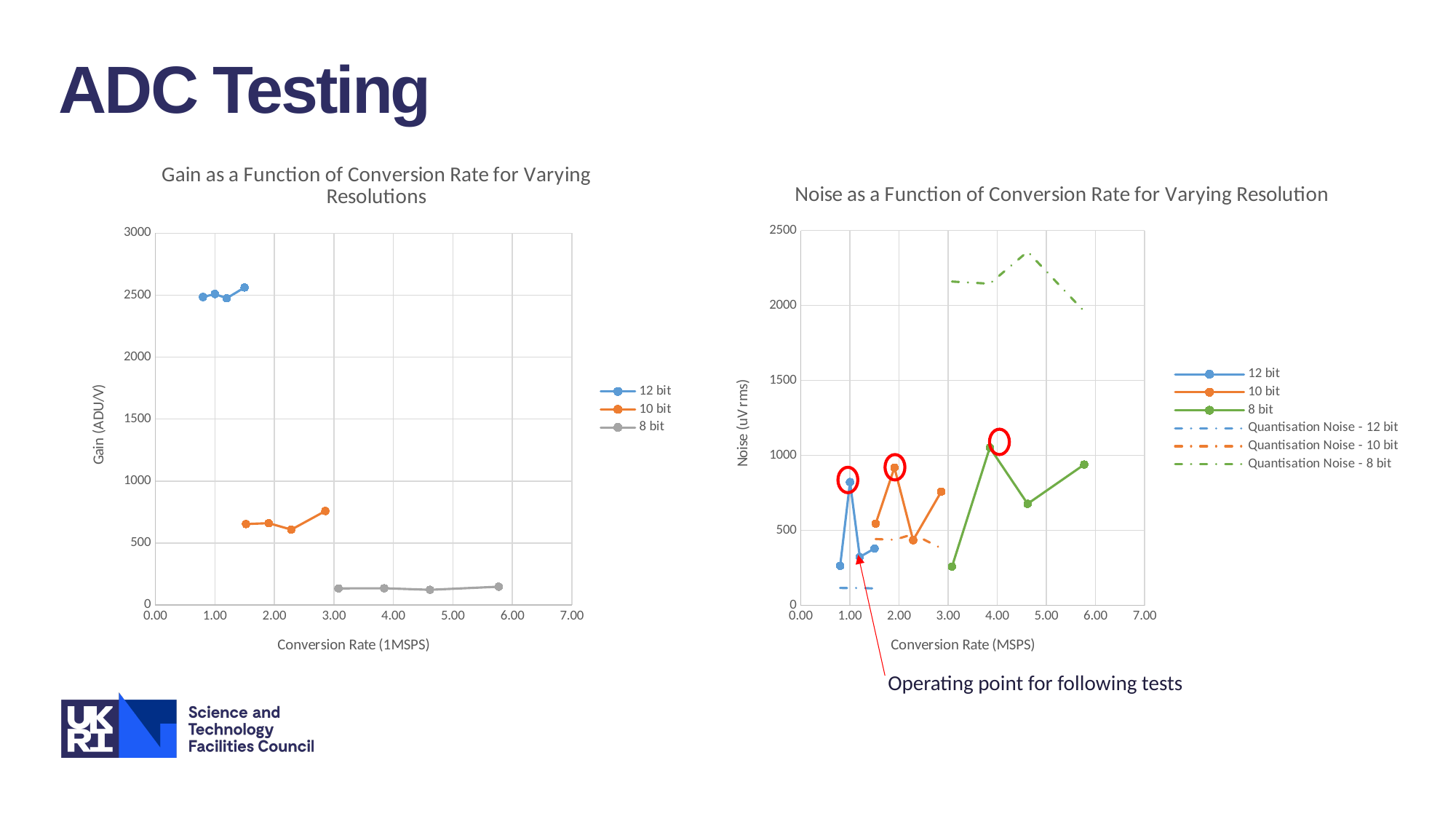
On the left chart, are the gain values for the 12 bit series greater or less than 2000? greater On the right chart, Noise as a Function of Conversion Rate, are the Quantisation Noise - 8 bit values greater or less than 1500? greater On the left chart, is the gain for the 10 bit series larger or smaller than the gain for the 8 bit series? larger On the left chart, Gain as a Function of Conversion Rate, which series has the highest gain? 12 bit On the left chart, Gain as a Function of Conversion Rate, which series has the lowest gain? 8 bit On the left chart, Gain as a Function of Conversion Rate for Varying Resolutions, how many series does the legend list? 3 On the right chart, Noise as a Function of Conversion Rate, how many data points are plotted for the 8 bit series? 4 On the right chart, Noise as a Function of Conversion Rate for Varying Resolution, how many entries does the legend list? 6 On the left chart, what is the label of the x axis? Conversion Rate (1MSPS) What kind of chart is the right chart, Noise as a Function of Conversion Rate for Varying Resolution? line chart On the left chart, are the gain values for the 8 bit series greater or less than 500? less On the right chart, what is the label of the y axis? Noise (uV rms)